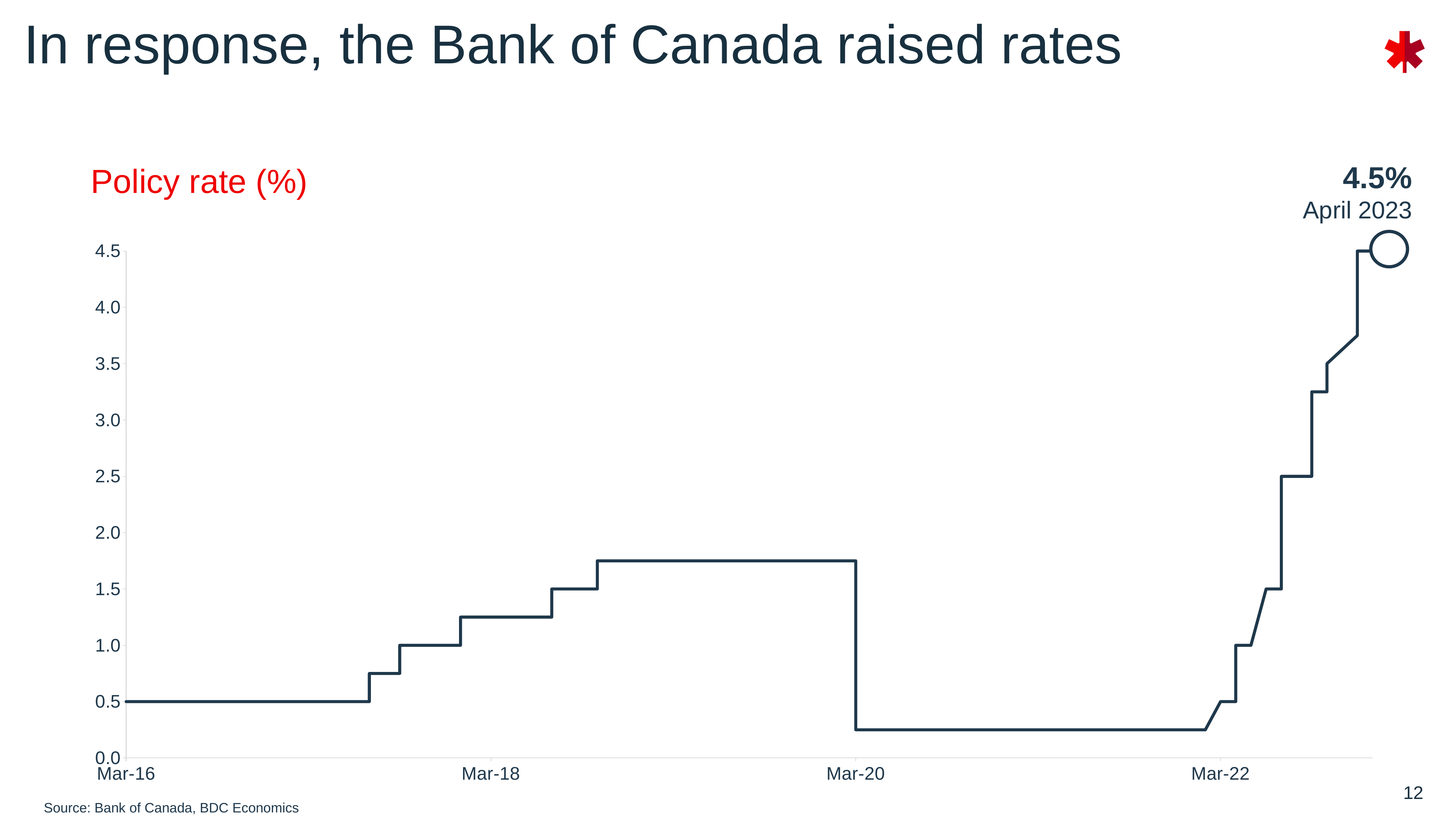
Is the lowest policy rate shown on the chart greater or less than 0.5? less How many series are plotted on the chart? 1 When does the policy rate reach its highest value on the chart? April 2023 Does the policy rate rise or fall between Mar-22 and April 2023? rise What is the policy rate in April 2023 according to the data label? 4.5% Which is higher, the policy rate at Mar-18 or at Mar-22? Mar-18 Is the policy rate at Mar-22 greater or less than 1.0? less What kind of chart is shown on the slide? line chart What is the difference between the policy rate in April 2023 (4.5%) and at Mar-16 (0.5)? 4.0 What is the label given for the plotted measure above the chart? Policy rate (%) What is the policy rate at Mar-16, the start of the chart? 0.5 Is the policy rate at Mar-18 greater or less than 1.0? greater